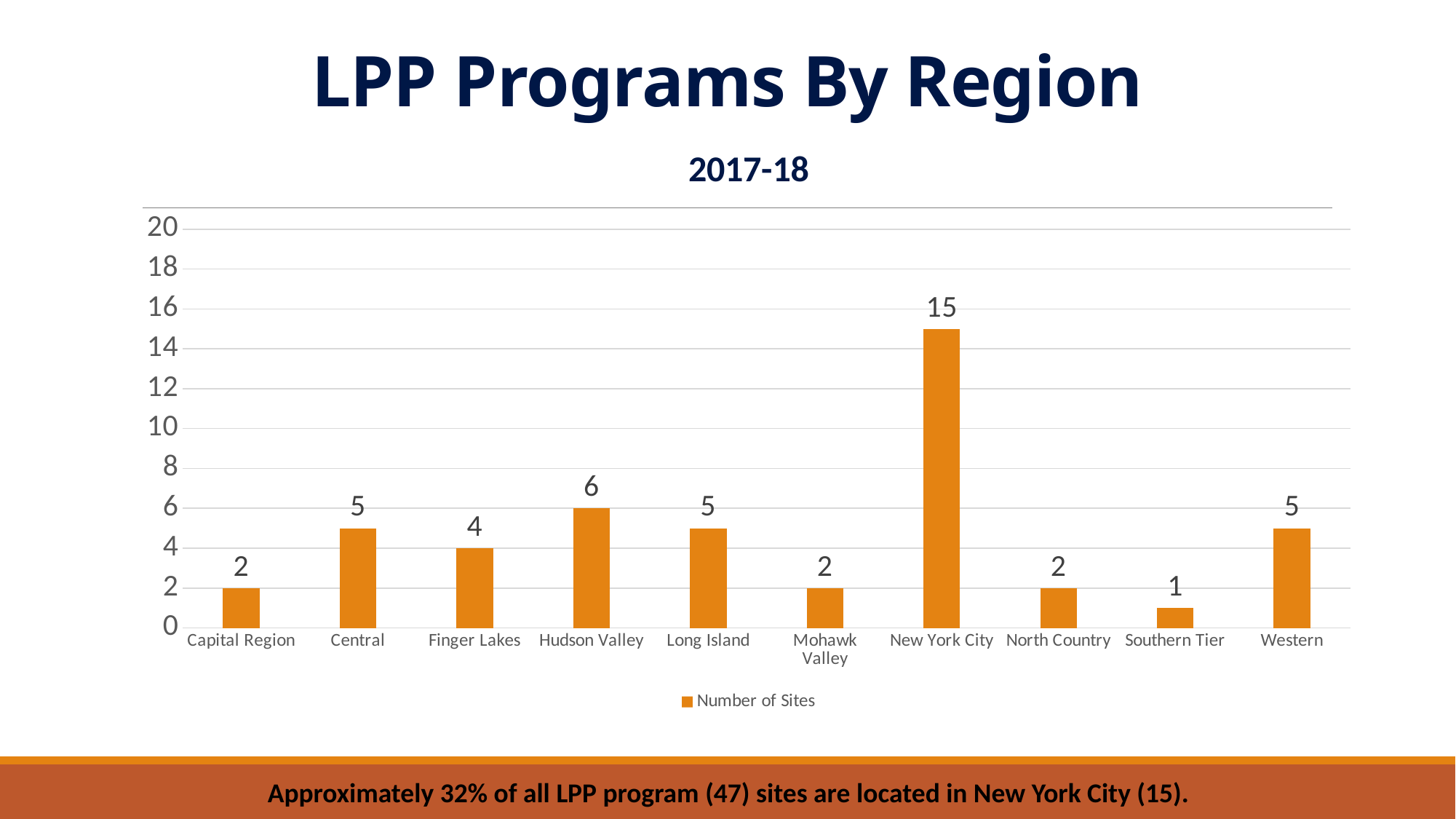
What is the number of sites for Hudson Valley? 6 How many regions are shown on the x axis? 10 Which has more sites, Finger Lakes or Long Island? Long Island What is the chart's title? 2017-18 Which region has the lowest number of sites? Southern Tier What is the number of sites for New York City? 15 What is the number of sites for Southern Tier? 1 What kind of chart is shown on the slide? bar chart Is the value for New York City greater or less than 10? greater How many series does the legend list? 1 Which region has the highest number of sites? New York City What is the difference in number of sites between New York City and Hudson Valley? 9